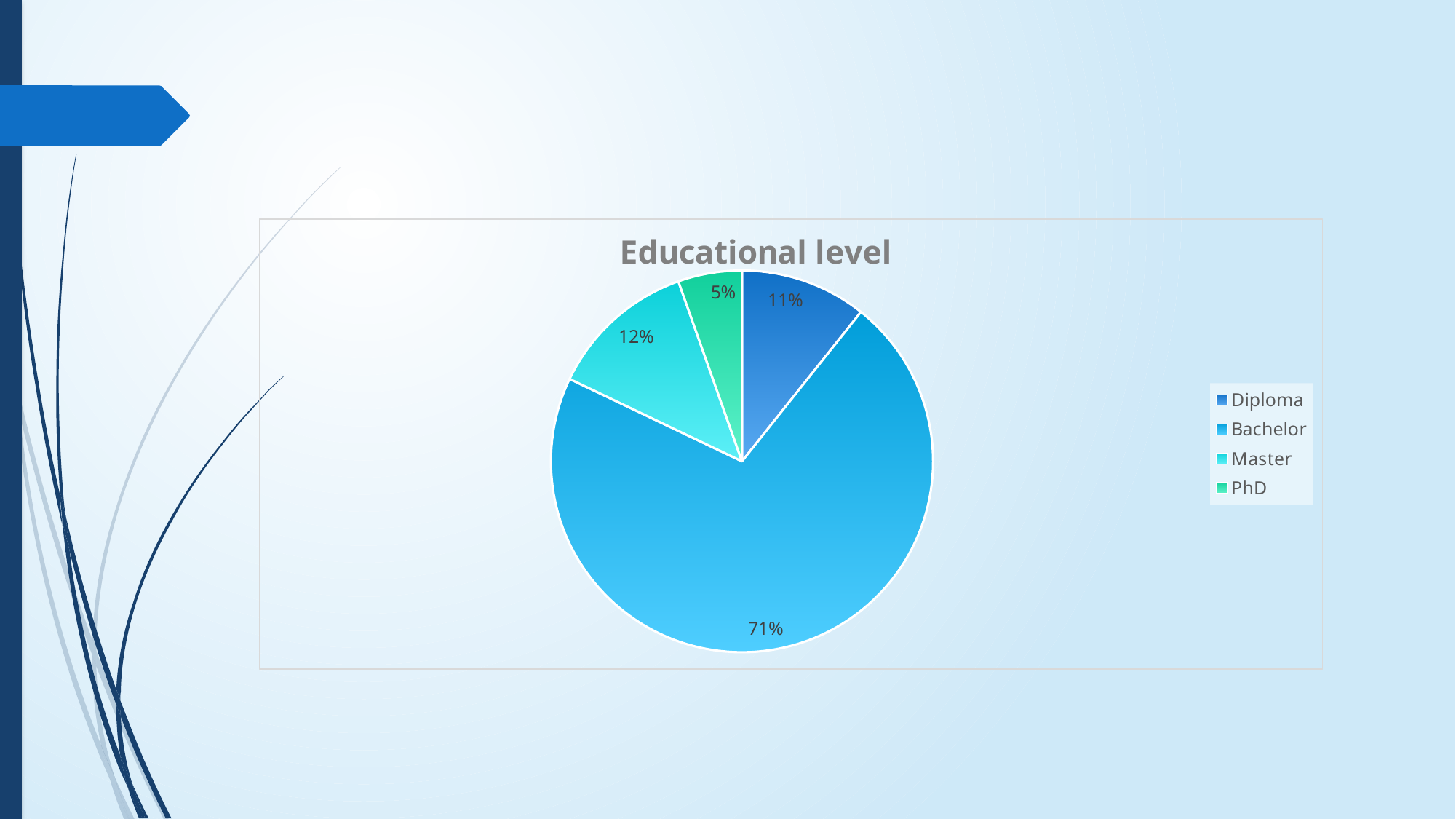
How many categories are shown in the pie chart? 4 Which educational level has the smallest slice? PhD What share of the pie does Master represent? 12% What share of the pie does PhD represent? 5% What is the title of the chart? Educational level Which is larger, the Diploma slice or the PhD slice? Diploma What share of the pie does Bachelor represent? 71% What is the difference in percentage points between Diploma and PhD? 6 What type of chart is shown on the slide? pie chart Which educational level has the largest slice? Bachelor What is the difference in percentage points between Bachelor and Master? 59